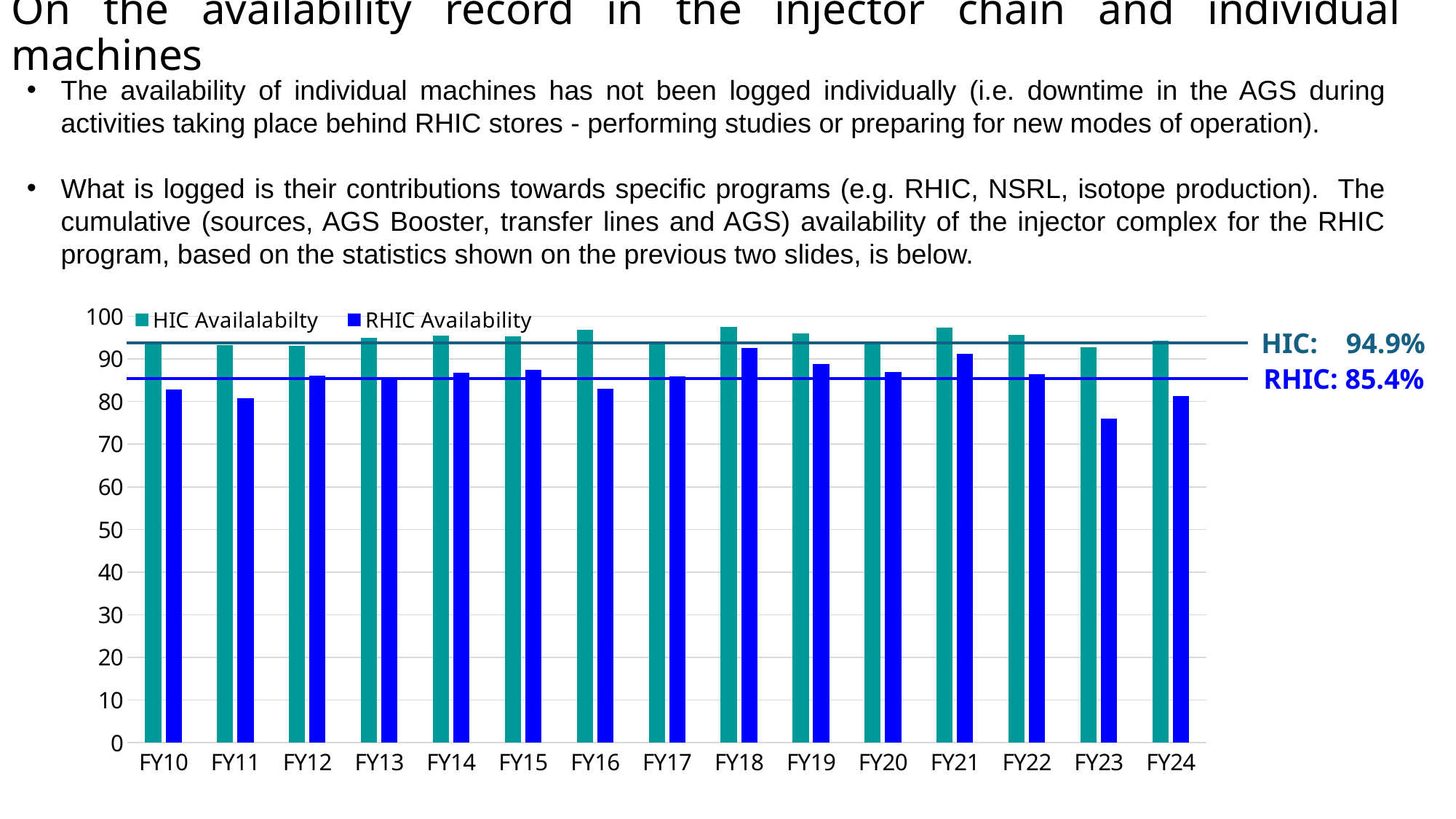
Which is larger: the RHIC Availability for FY18 or for FY23? FY18 In FY10, which is larger: HIC Availalabilty or RHIC Availability? HIC Availalabilty How many fiscal years are shown on the x axis of the chart? 15 Is the RHIC Availability for FY11 greater or less than 90? less Is the RHIC Availability for FY23 greater or less than 80? less Which fiscal year has the lowest RHIC Availability? FY23 Is the HIC Availalabilty for FY18 greater or less than 90? greater What RHIC value is labelled next to the horizontal reference line on the chart? 85.4% How many series does the chart legend list? 2 What kind of chart is shown on the slide? bar chart What HIC value is labelled next to the horizontal reference line on the chart? 94.9%